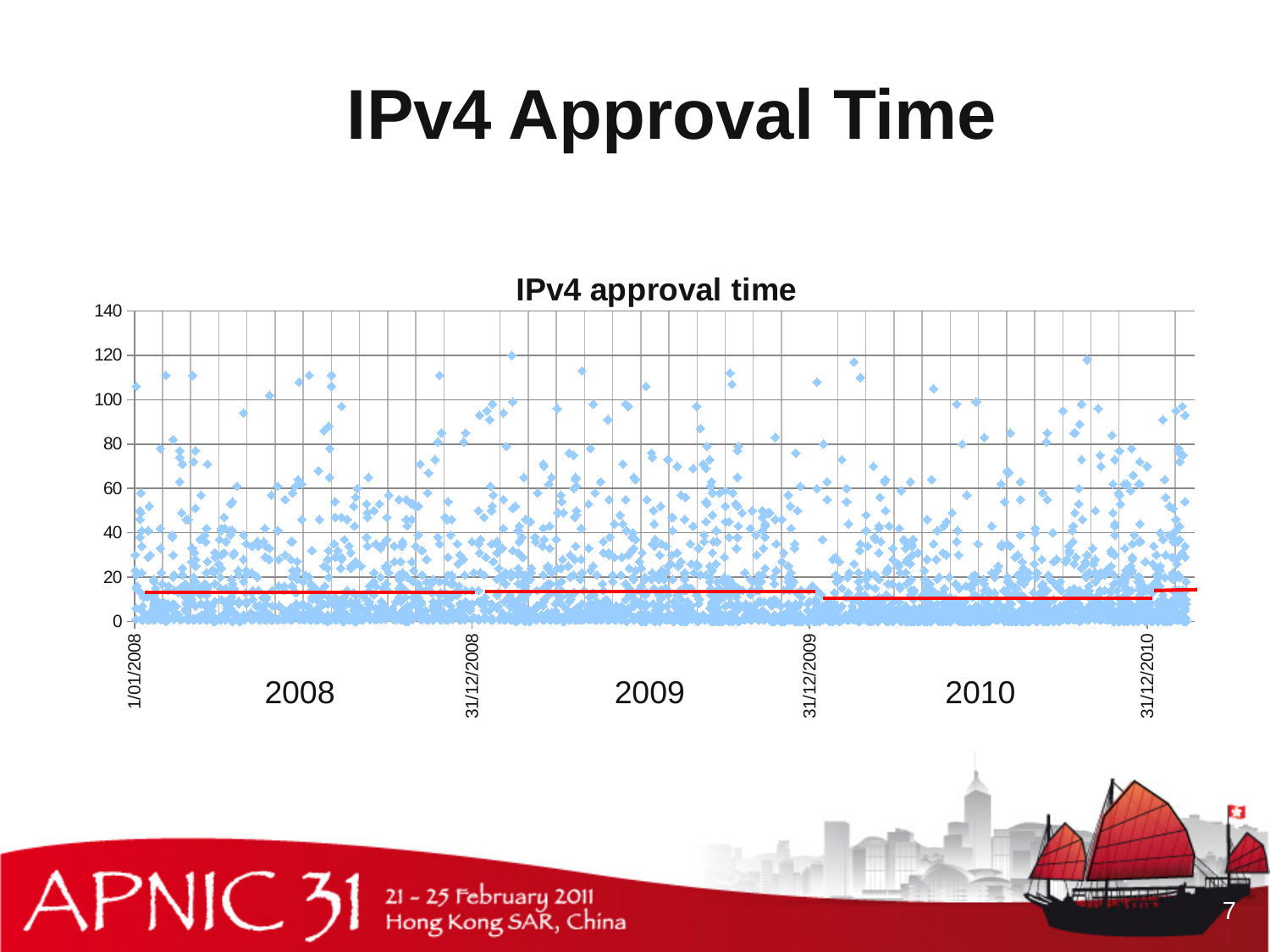
What kind of chart is shown on the slide? scatter chart Are most of the plotted points above or below 40? below Is the red horizontal line for 2010 higher or lower than the red horizontal line for 2009? lower Is the red horizontal line for 2010 greater or less than 20? less What is the first date label on the x axis? 1/01/2008 What is the title of the chart? IPv4 approval time What is the interval between consecutive tick labels on the y axis? 20 How many year labels (2008, 2009, 2010) are shown beneath the x axis? 3 What is the highest value shown on the y axis of the chart? 140 What is the last date label on the x axis? 31/12/2010 Is the red horizontal line for 2008 greater or less than 20? less